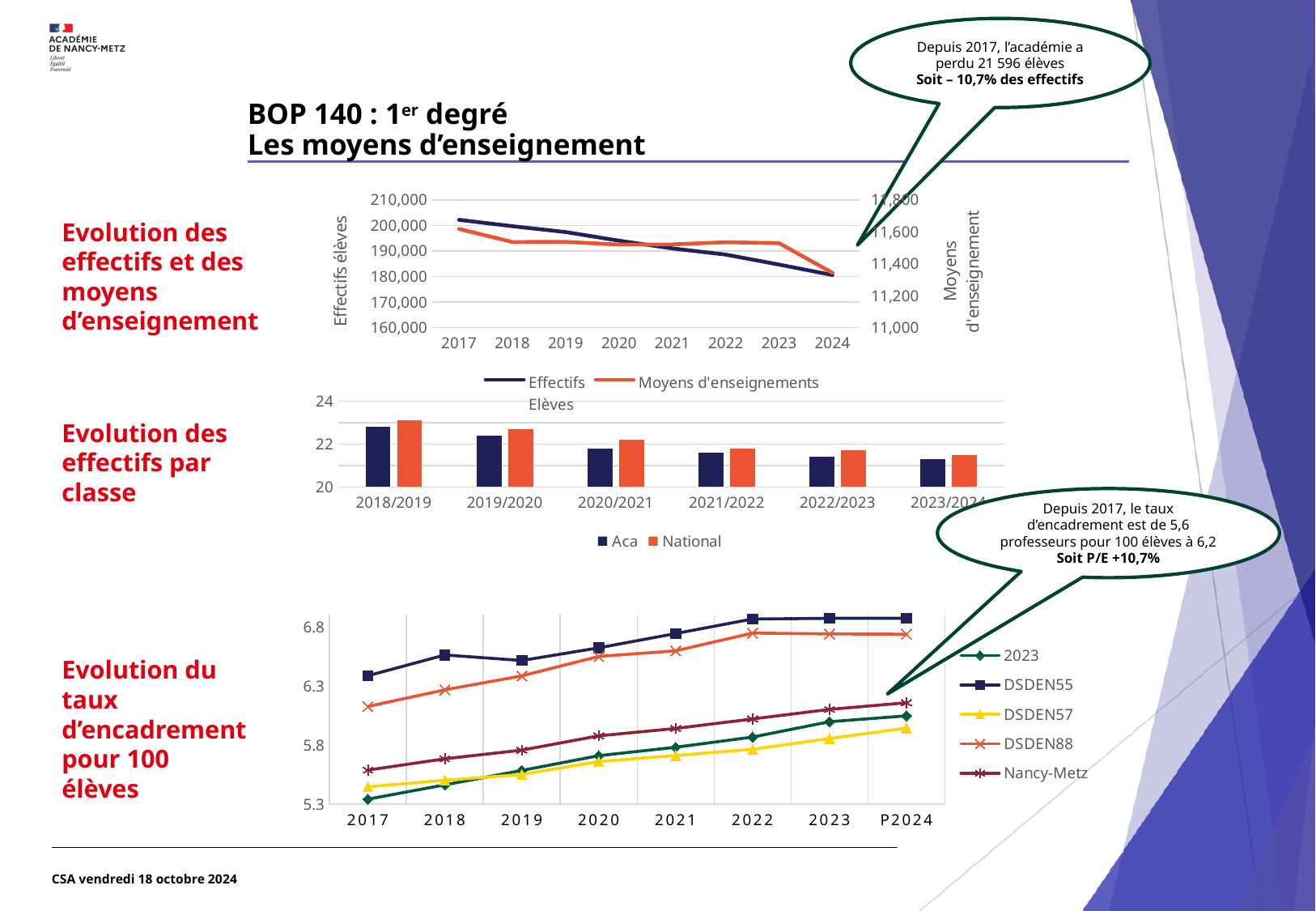
In the top chart ('Evolution des effectifs et des moyens d'enseignement'), does the Effectifs line rise or fall from 2017 to 2024? fall In the middle chart ('Evolution des effectifs par classe'), is the Aca value for 2018/2019 greater or less than 22? greater In the bottom chart ('Evolution du taux d'encadrement pour 100 élèves'), which series has the highest value in 2017? DSDEN55 How many years are shown on the x axis of the top chart ('Evolution des effectifs et des moyens d'enseignement')? 8 How many series does the legend of the bottom chart ('Evolution du taux d'encadrement pour 100 élèves') list? 5 In the middle chart ('Evolution des effectifs par classe'), which is larger for 2018/2019, Aca or National? National In the middle chart ('Evolution des effectifs par classe'), do the Aca values rise or fall from 2018/2019 to 2023/2024? fall What kind of chart is the middle chart, 'Evolution des effectifs par classe'? bar chart What kind of chart is the top chart, 'Evolution des effectifs et des moyens d'enseignement'? line chart How many series does the legend of the top chart ('Evolution des effectifs et des moyens d'enseignement') list? 2 In the bottom chart ('Evolution du taux d'encadrement pour 100 élèves'), is the DSDEN57 value for 2017 greater or less than 5.8? less How many school-year categories are shown in the middle chart ('Evolution des effectifs par classe')? 6